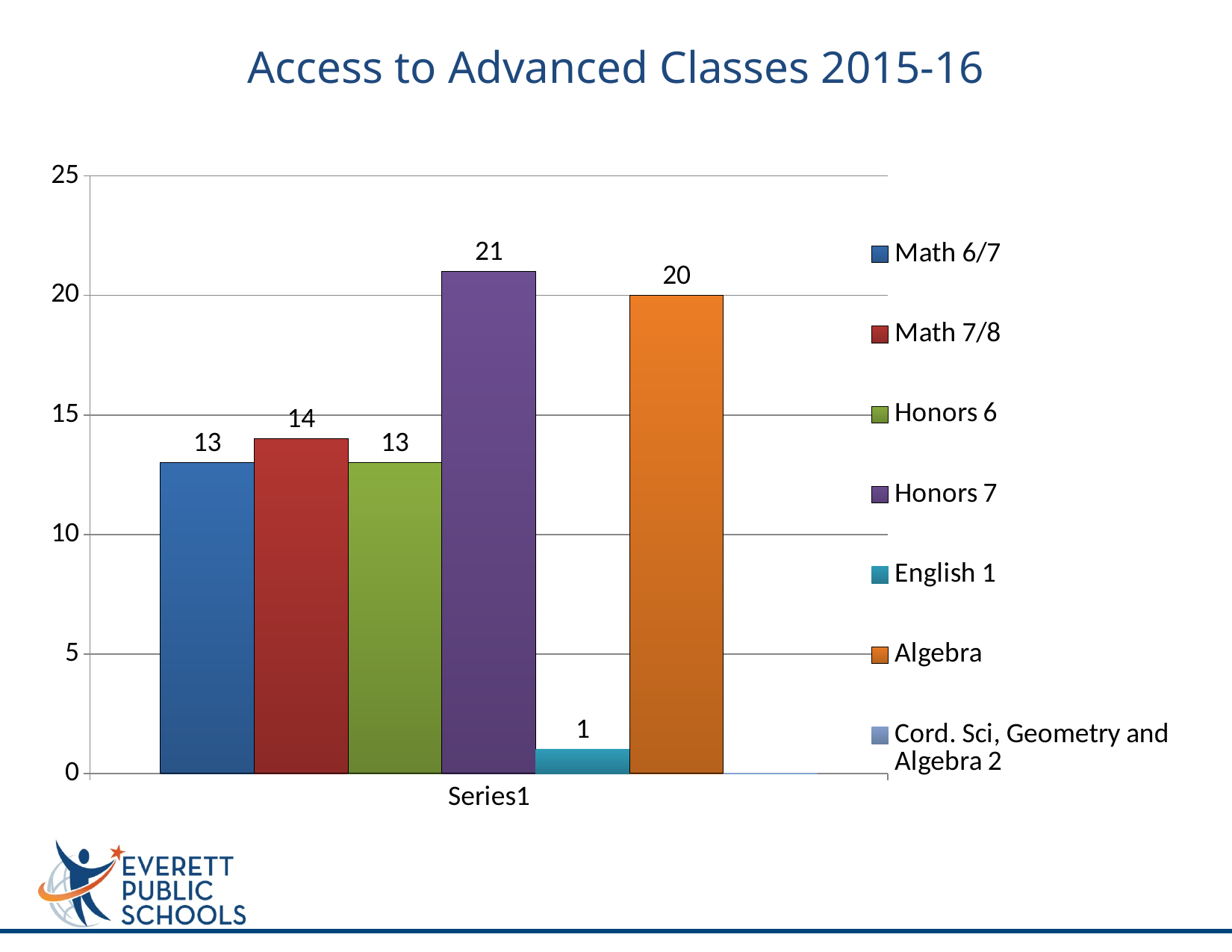
What is the value for Math 7/8? 14 How many series does the legend list? 7 What is the title of the chart? Access to Advanced Classes 2015-16 What kind of chart is shown on the slide? Bar chart Which series has the highest value? Honors 7 What is the value for Algebra? 20 What is the value for Honors 7? 21 What is the difference between the values for Algebra and English 1? 19 What is the value for Math 6/7? 13 What is the value for English 1? 1 Which is larger, the value for Math 7/8 or the value for Honors 6? Math 7/8 What is the difference between the values for Honors 7 and Algebra? 1